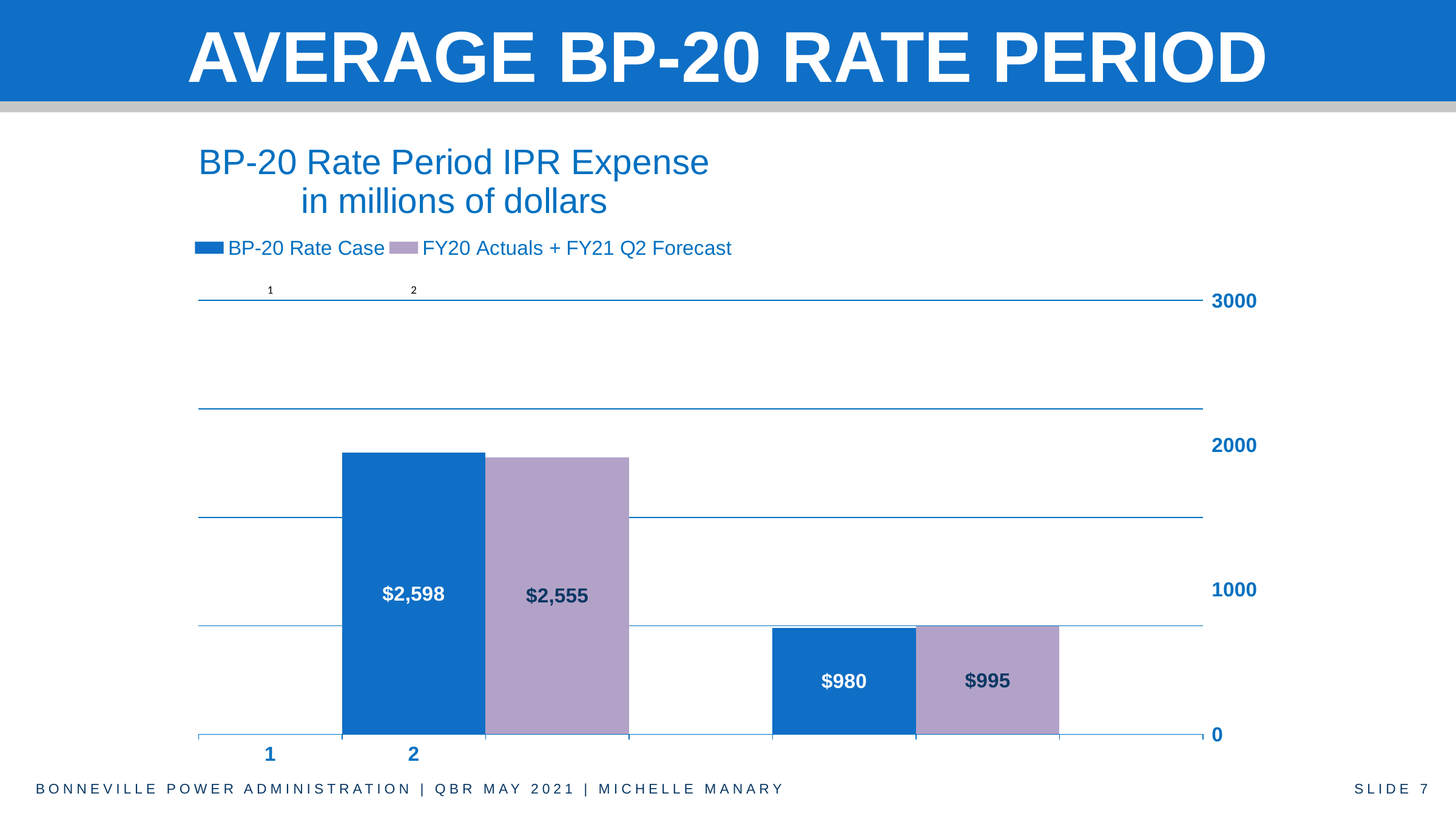
In the left group of bars, what is the difference between the BP-20 Rate Case value and the FY20 Actuals + FY21 Q2 Forecast value? $43 In the right group of bars, what is the difference between the FY20 Actuals + FY21 Q2 Forecast value and the BP-20 Rate Case value? $15 What is the lowest value shown on the chart? $980 What is the highest value shown on the chart? $2,598 How many series does the legend list? 2 What is the BP-20 Rate Case value for the right group of bars? $980 What kind of chart is shown on the slide? Bar chart In the left group of bars, which series has the larger value: BP-20 Rate Case or FY20 Actuals + FY21 Q2 Forecast? BP-20 Rate Case What is the FY20 Actuals + FY21 Q2 Forecast value for the left group of bars? $2,555 In the right group of bars, which series has the larger value: BP-20 Rate Case or FY20 Actuals + FY21 Q2 Forecast? FY20 Actuals + FY21 Q2 Forecast What is the FY20 Actuals + FY21 Q2 Forecast value for the right group of bars? $995 What is the BP-20 Rate Case value for the left group of bars? $2,598